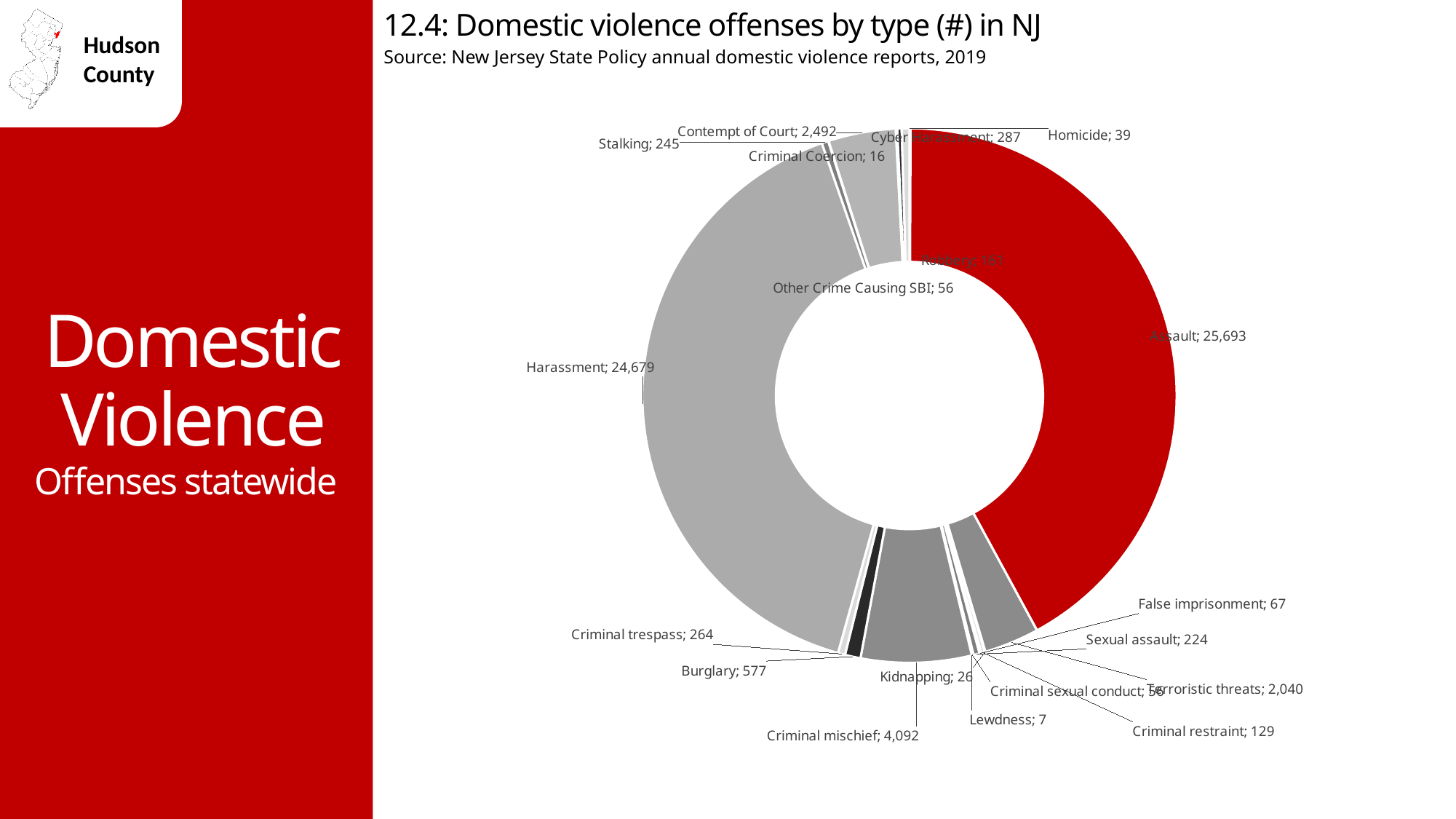
Which offense type has the largest number of offenses? Assault Which offense type has the smallest number of offenses? Lewdness Which has more offenses, Burglary or Criminal trespass? Burglary What value is shown for Terroristic threats? 2,040 What is the number of Harassment offenses shown on the chart? 24,679 What is the number of Assault offenses shown on the chart? 25,693 What is the difference between Criminal mischief and Contempt of Court offenses? 1,600 What type of chart is used on this slide? Pie (doughnut) chart What value is shown for Contempt of Court? 2,492 How many Homicide offenses are shown on the chart? 39 How many Criminal mischief offenses does the chart show? 4,092 What is the difference between the number of Assault offenses and Harassment offenses? 1,014